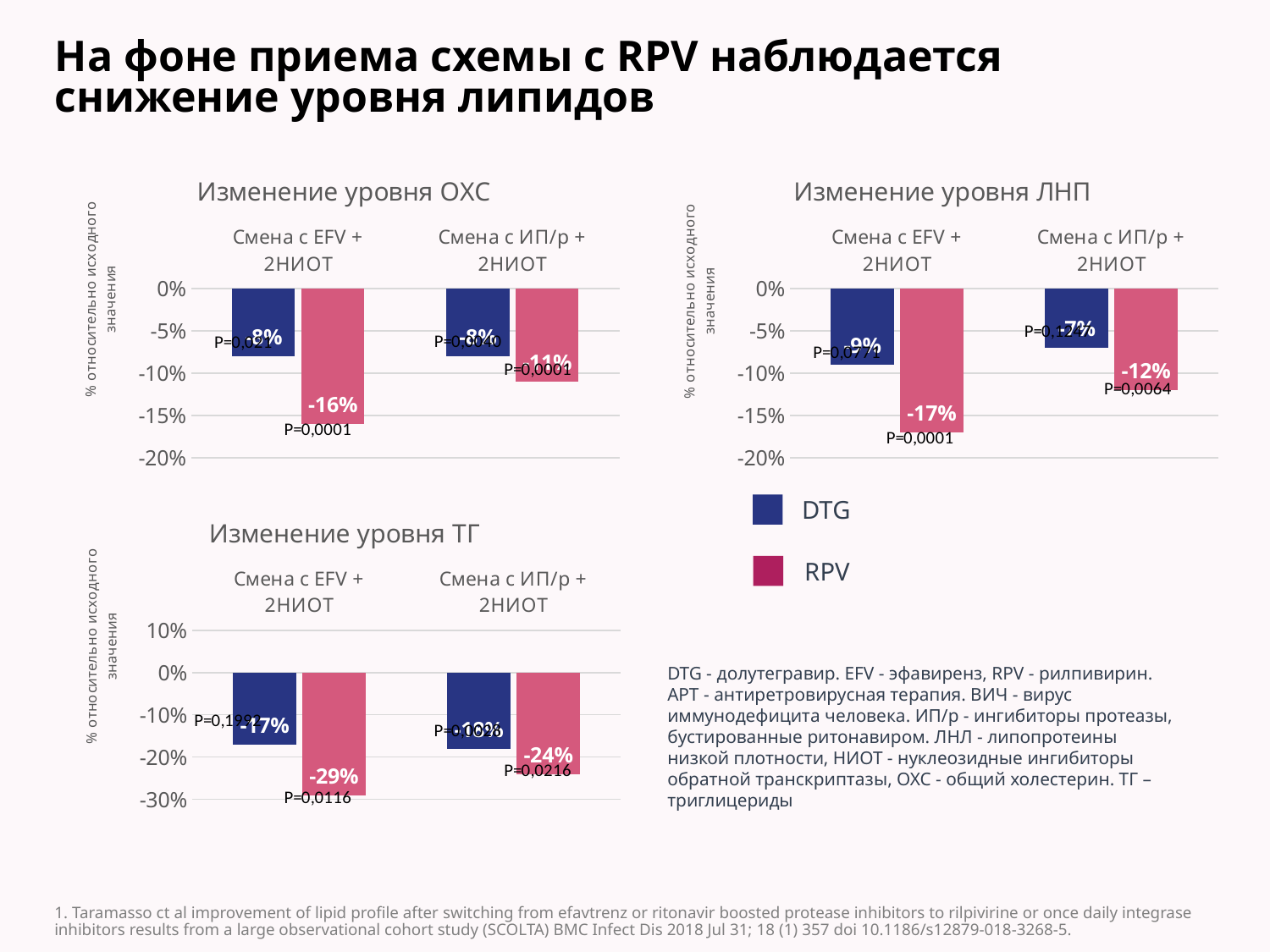
In the chart titled "Изменение уровня ТГ", what is the value for RPV in the "Смена с ИП/р + 2НИОТ" group? -24% In the chart titled "Изменение уровня ЛНП", what is the value for RPV in the "Смена с EFV + 2НИОТ" group? -17% In the chart titled "Изменение уровня ТГ", which bar has the lowest value? RPV in the Смена с EFV + 2НИОТ group (-29%) How many series does the legend on the slide list? 2 In the chart titled "Изменение уровня ТГ", is the value for DTG in the "Смена с ИП/р + 2НИОТ" group greater or less than -10%? less In the chart titled "Изменение уровня ЛНП", what is the value for RPV in the "Смена с ИП/р + 2НИОТ" group? -12% What kind of chart is "Изменение уровня ОХС"? Bar chart In the chart titled "Изменение уровня ОХС", what is the value for RPV in the "Смена с EFV + 2НИОТ" group? -16% How many switch groups are shown on the x axis of the chart titled "Изменение уровня ЛНП"? 2 In the chart titled "Изменение уровня ТГ", what is the difference between the DTG value (-17%) and the RPV value (-29%) in the "Смена с EFV + 2НИОТ" group? 12 percentage points In the chart titled "Изменение уровня ТГ", which series shows the larger decrease in the "Смена с EFV + 2НИОТ" group, DTG or RPV? RPV In the chart titled "Изменение уровня ТГ", what is the value for RPV in the "Смена с EFV + 2НИОТ" group? -29%